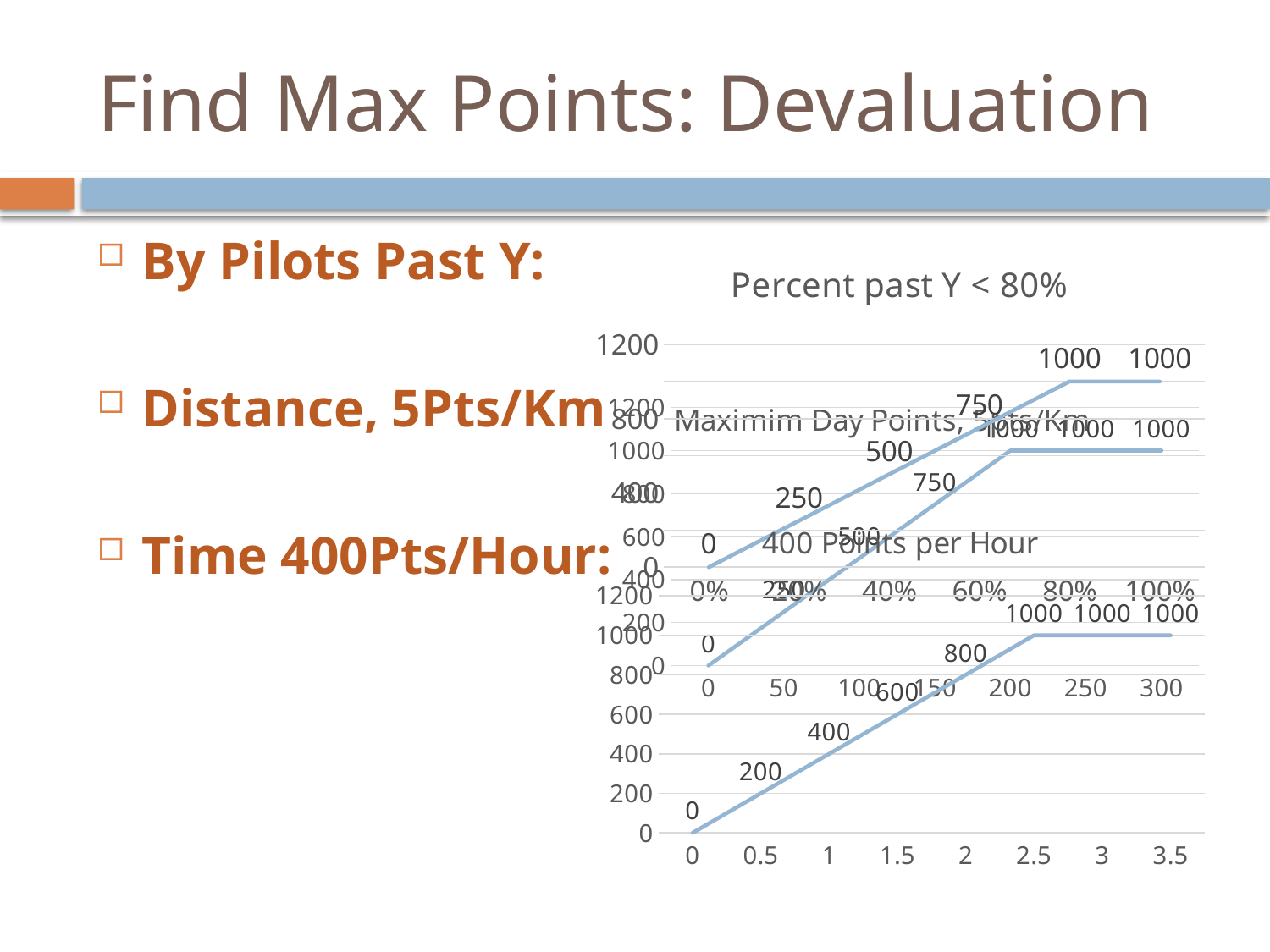
In the "400 Points per Hour" chart, what is the value at 0 hours? 0 In the "Percent past Y < 80%" chart, what is the value at 0%? 0 In the "400 Points per Hour" chart, do the values rise or fall from 0 to 2.5 hours? rise In the "Percent past Y < 80%" chart, what is the value at 100%? 1000 What is the title of the topmost chart on the slide? Percent past Y < 80% In the "400 Points per Hour" chart, what is the value at 1 hour? 400 In the "400 Points per Hour" chart, what is the difference between the values at 2 hours and 1 hour? 400 In the "400 Points per Hour" chart, how many data points are labelled? 8 In the "400 Points per Hour" chart, what is the highest value reached? 1000 In the "Maximim Day Points, 5Pts/Km" chart, what is the value at 300? 1000 In the "400 Points per Hour" chart, what is the value at 2 hours? 800 What kind of chart is the "400 Points per Hour" chart? line chart